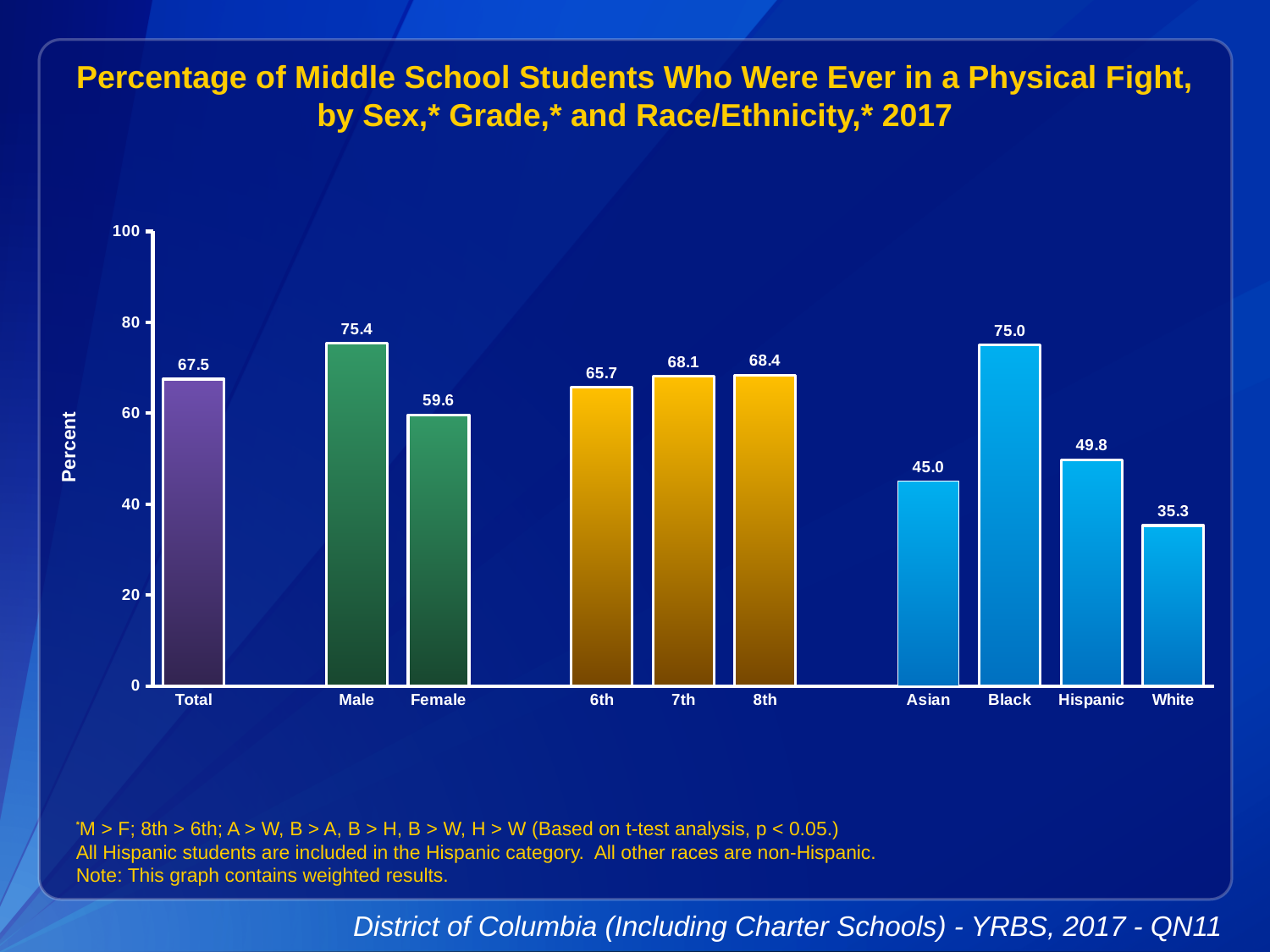
Which is larger, the value for Asian or the value for Hispanic? Hispanic Which category has the highest value? Male What is the value for Female? 59.6 What is the difference between the Male and Female values? 15.8 What is the difference between the Black and White values? 39.7 What is the value for Hispanic? 49.8 What is the value for Total? 67.5 What is the label on the vertical axis? Percent Which category has the lowest value? White How many bars are shown in the chart? 10 What kind of chart is this? Bar chart What is the value for 7th grade? 68.1